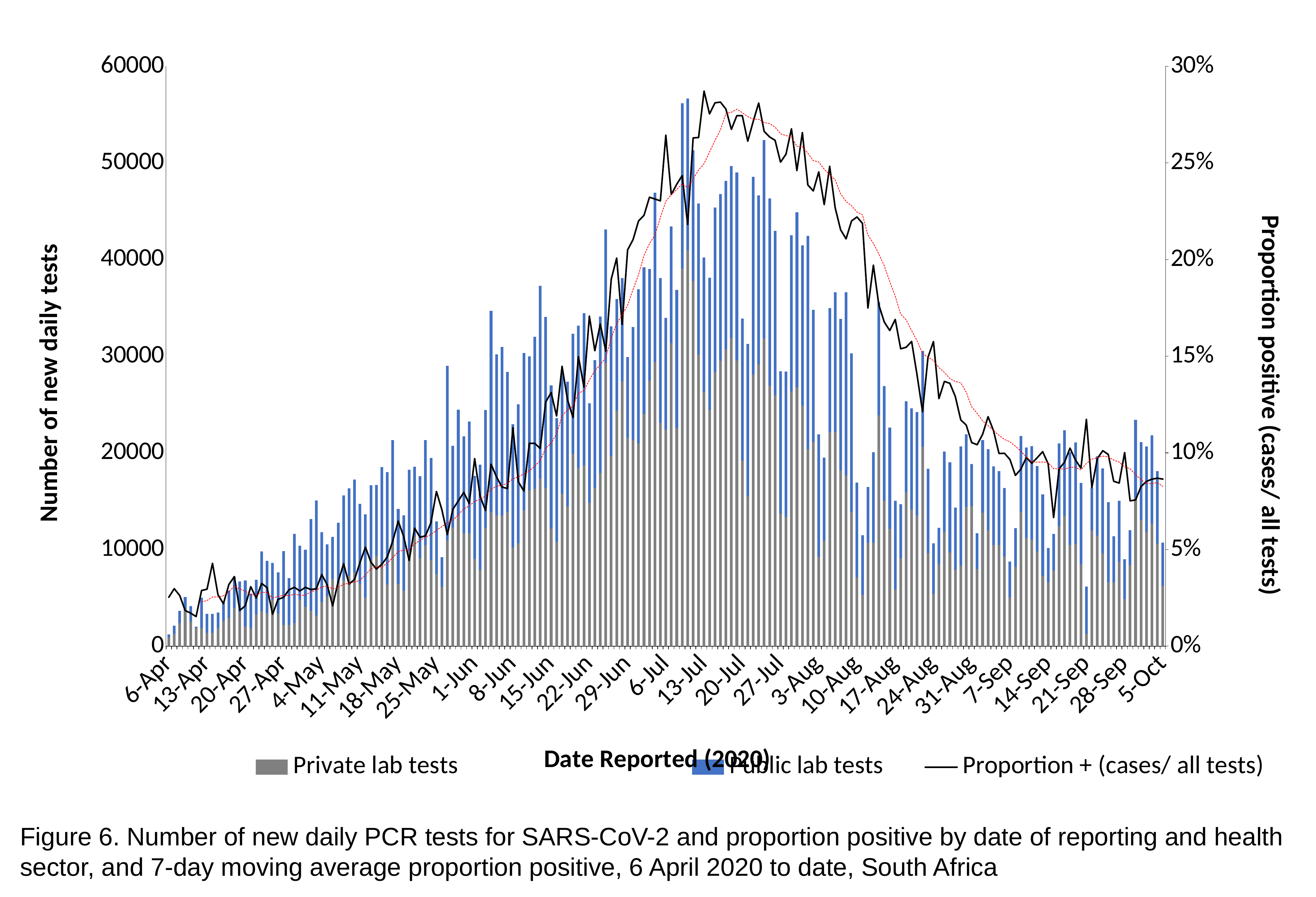
What is the title of the left vertical axis? Number of new daily tests Is the total number of new daily tests on 6-Apr greater or less than 10000? less How many series does the legend list? 3 Is the proportion positive on 6-Apr greater or less than 5%? less Is the highest total number of daily tests (around 13-Jul) greater or less than 50000? greater What kind of chart is shown on the slide? A bar chart combined with a line chart Which series is shown in gray bars? Private lab tests How does the number of new daily tests change from mid-July to October? It falls How does the proportion positive change from April to mid-July? It rises In which month does the number of new daily tests reach its peak? July